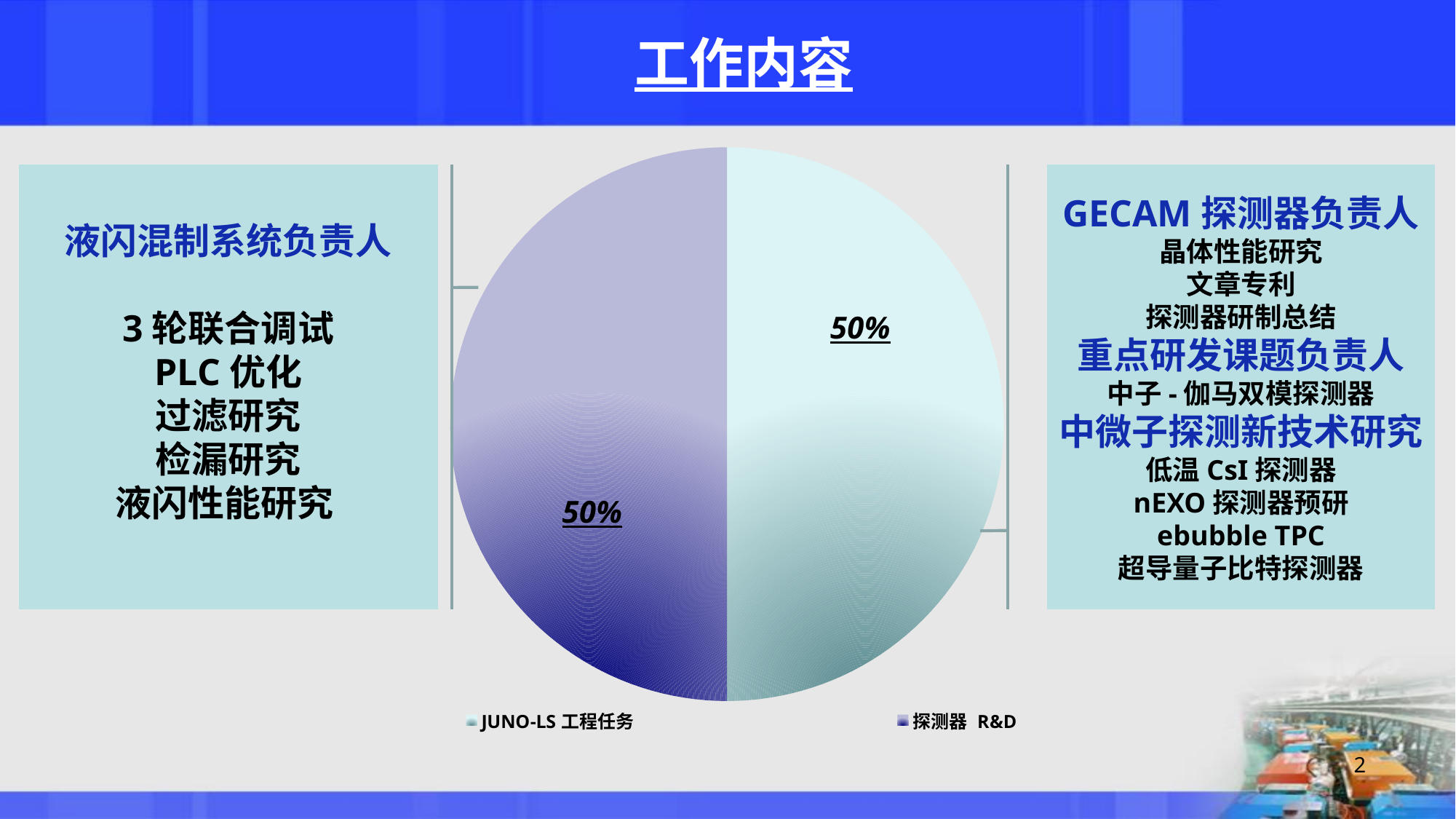
What kind of chart is shown on the slide? pie chart What percentage is shown for the 探测器 R&D slice? 50% What is the difference between the JUNO-LS 工程任务 share and the 探测器 R&D share? 0% Which legend entry is shown in light cyan in the pie chart? JUNO-LS 工程任务 What percentage is shown for the JUNO-LS 工程任务 slice? 50% Is the share for JUNO-LS 工程任务 larger than, smaller than, or equal to the share for 探测器 R&D? equal Which legend entry is shown in purple in the pie chart? 探测器 R&D How many entries does the legend of the pie chart list? 2 What share of the pie does 探测器 R&D take? 50% What share of the pie does JUNO-LS 工程任务 take? 50% How many slices does the pie chart have? 2 What do the two slices of the pie chart add up to? 100%